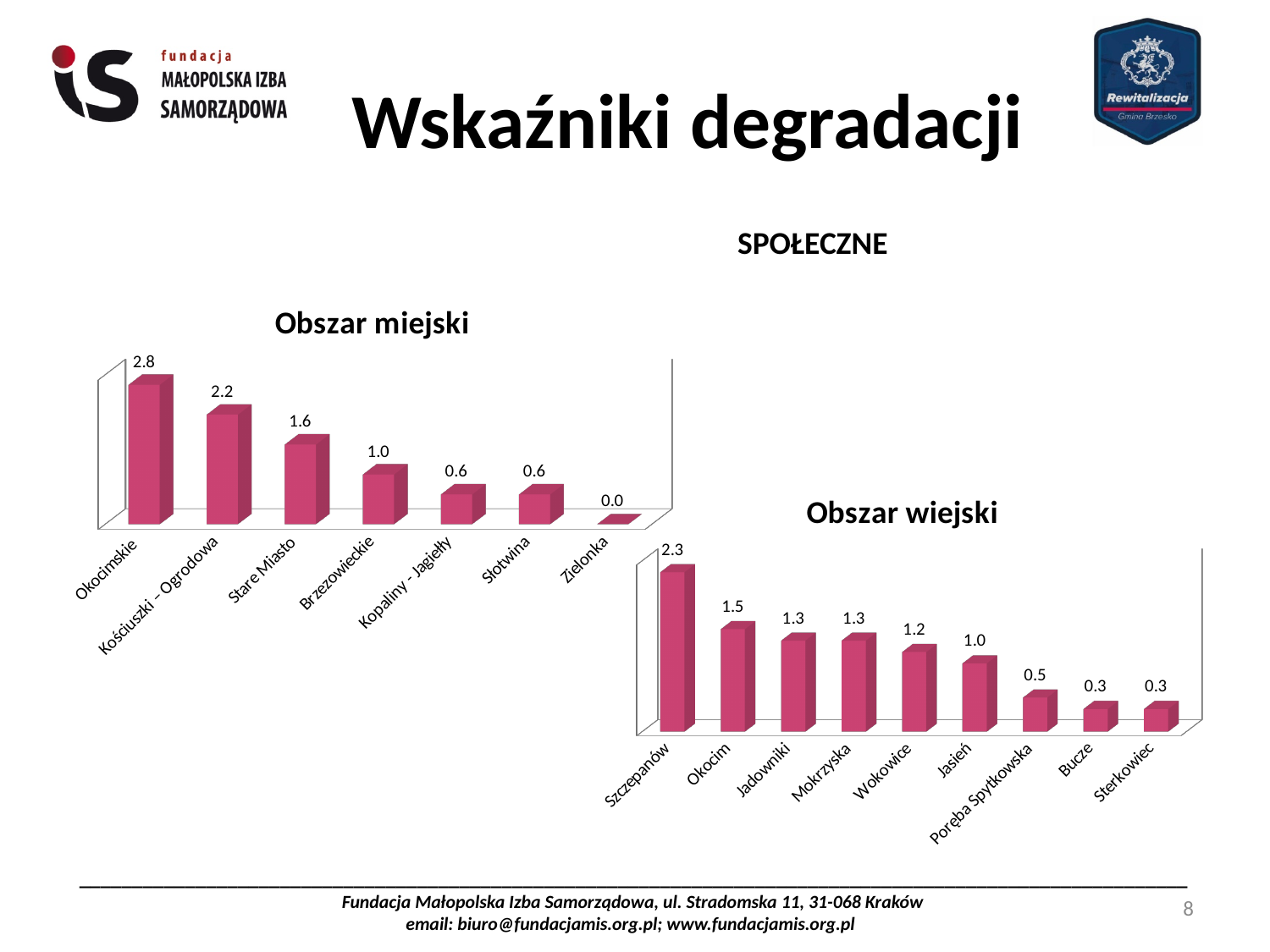
In the 'Obszar wiejski' chart, which category has the highest value? Szczepanów What kind of chart is the 'Obszar wiejski' chart? bar chart In the 'Obszar wiejski' chart, how many categories are shown? 9 In the 'Obszar miejski' chart, which category has the lowest value? Zielonka In the 'Obszar miejski' chart, do the values rise or fall from left to right? fall In the 'Obszar miejski' chart, what is the value for Brzezowieckie? 1.0 In the 'Obszar wiejski' chart, what is the value for Poręba Spytkowska? 0.5 In the 'Obszar wiejski' chart, what is the value for Szczepanów? 2.3 In the 'Obszar miejski' chart, how many categories are shown? 7 In the 'Obszar miejski' chart, what is the value for Okocimskie? 2.8 In the 'Obszar wiejski' chart, which is larger, Okocim or Wokowice? Okocim In the 'Obszar miejski' chart, what is the difference between Okocimskie and Stare Miasto? 1.2